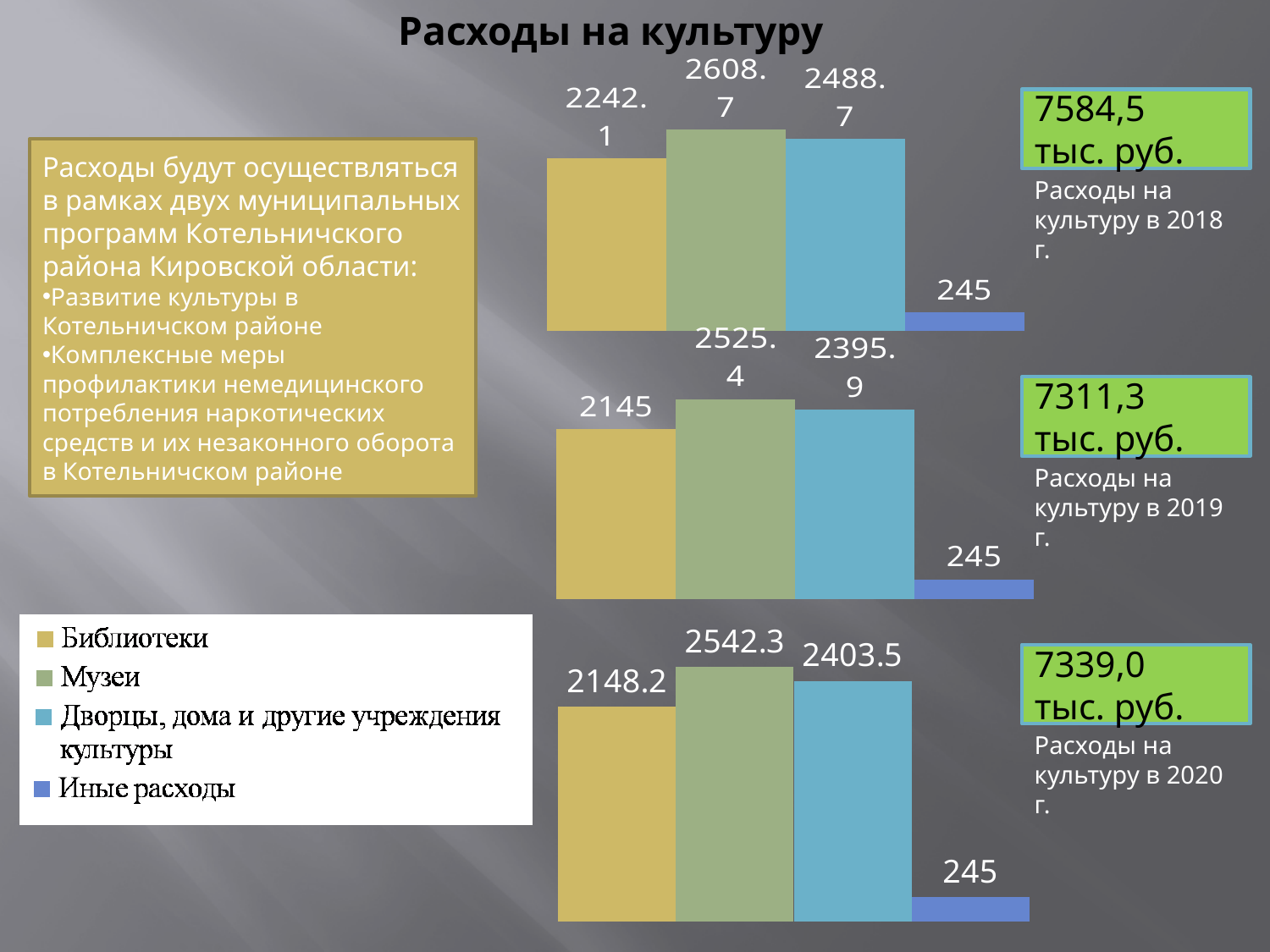
In the middle chart (Расходы на культуру в 2019 г.), what is the value for Дворцы, дома и другие учреждения культуры? 2395.9 In the bottom chart (2020), which category has the highest value? Музеи In the top chart (2018), what is the difference between the values for Музеи and Библиотеки? 366.6 How many series does the legend list? 4 In the top chart (Расходы на культуру в 2018 г.), what is the value for Музеи? 2608.7 In the top chart (2018), what is the value for Библиотеки? 2242.1 In the middle chart (2019), which is larger: the value for Музеи or the value for Библиотеки? Музеи In the bottom chart (Расходы на культуру в 2020 г.), what is the value for Музеи? 2542.3 How many bars are plotted in the bottom chart (2020)? 4 What is the value for Иные расходы in the bottom chart (2020)? 245 In the middle chart (2019), which category has the lowest value? Иные расходы What kind of chart is used to show the 2018 expenses? Bar chart